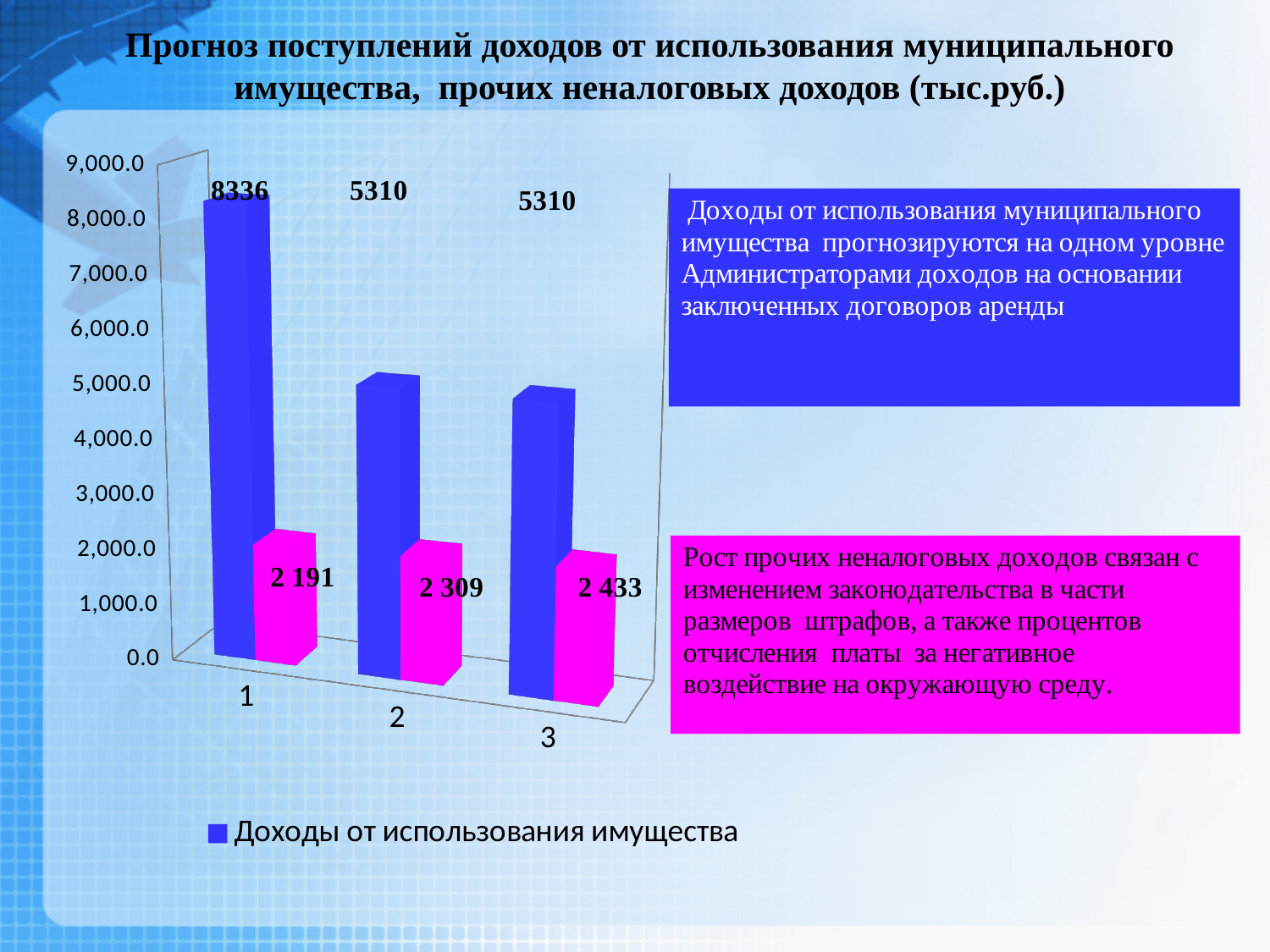
What kind of chart is shown on the slide? bar chart What is the value of the magenta bar for category 3? 2 433 What is the difference between the Доходы от использования имущества values for category 1 and category 2? 3026 By how much does the magenta bar value for category 3 exceed that for category 1? 242 What is the value of the blue bar (Доходы от использования имущества) for category 1? 8336 Which category has the lowest magenta bar value? 1 What series name is listed in the chart legend? Доходы от использования имущества How many series does the chart legend list? 1 How many categories are shown on the x axis of the chart? 3 Which category has the highest value for Доходы от использования имущества? 1 What is the value of the magenta bar for category 1? 2 191 Do the magenta bar values rise or fall from category 1 to category 3? rise